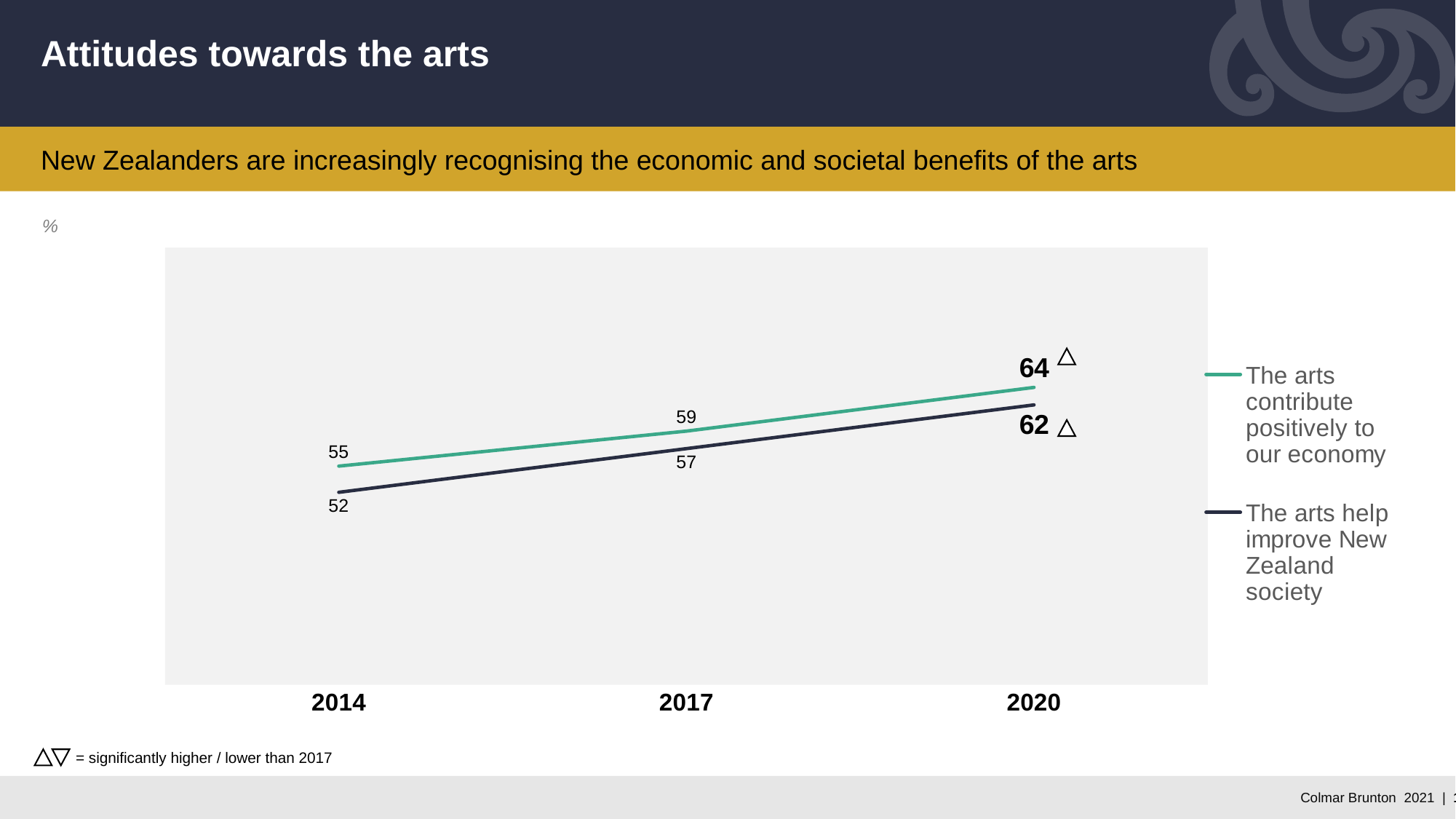
In which year is 'The arts help improve New Zealand society' highest? 2020 By how much did 'The arts contribute positively to our economy' increase from 2014 to 2020? 9 How many years are shown on the x axis? 3 What is the value for 'The arts contribute positively to our economy' in 2017? 59 What is the value for 'The arts help improve New Zealand society' in 2020? 62 What is the value for 'The arts contribute positively to our economy' in 2020? 64 Which series has the higher value in 2017? The arts contribute positively to our economy In which year is 'The arts contribute positively to our economy' lowest? 2014 What kind of chart is shown on the slide? Line chart How many series does the legend list? 2 What is the value for 'The arts help improve New Zealand society' in 2014? 52 What is the difference between the two series in 2014? 3